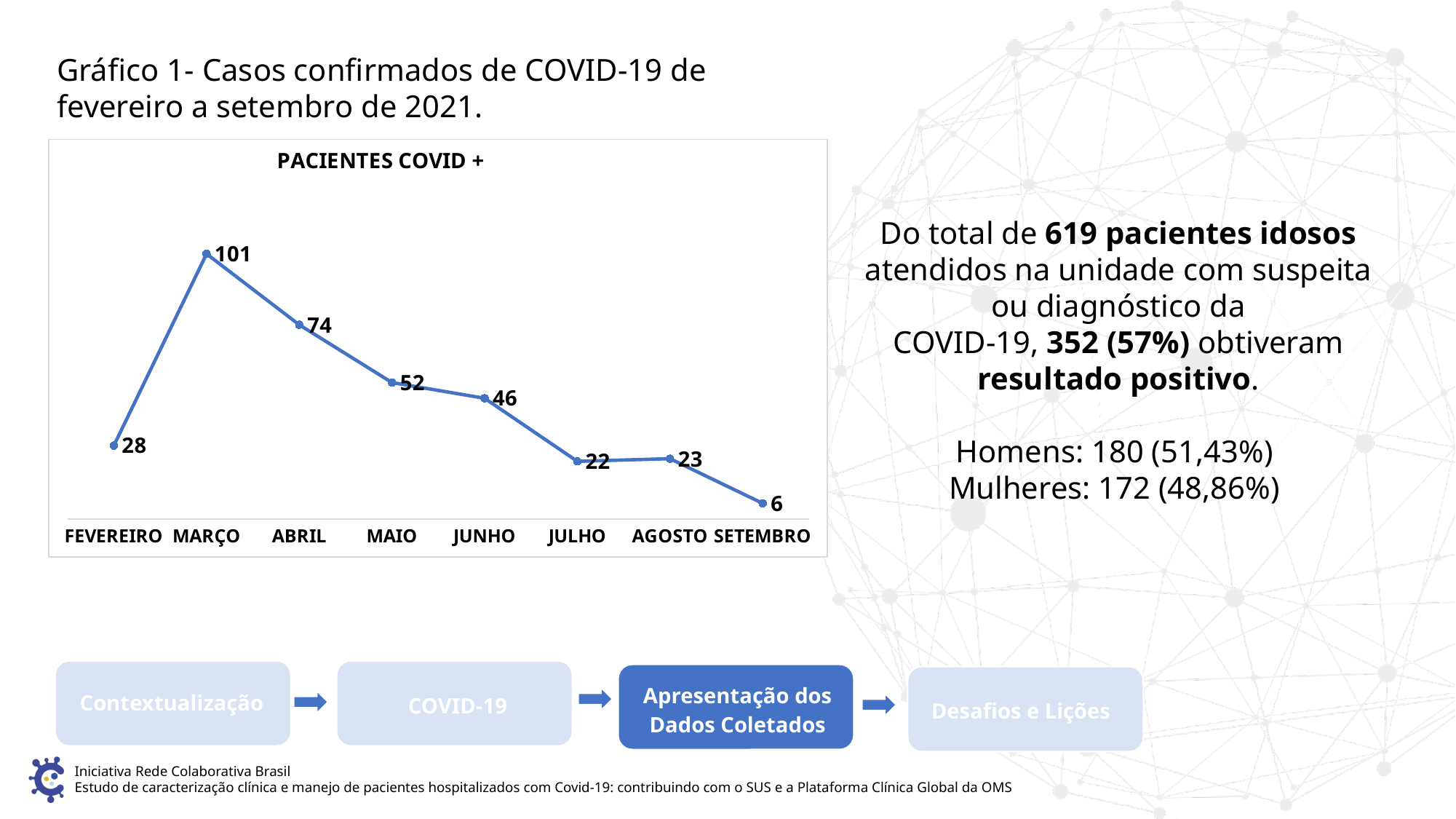
How many months are plotted in the PACIENTES COVID + chart? 8 What is the difference between the values for MAIO and JUNHO in the PACIENTES COVID + chart? 6 Which is larger in the PACIENTES COVID + chart, the value for FEVEREIRO or the value for JULHO? FEVEREIRO What is the value for JUNHO in the PACIENTES COVID + chart? 46 Which month has the lowest value in the PACIENTES COVID + chart? SETEMBRO What kind of chart is the PACIENTES COVID + chart? line chart Do the values in the PACIENTES COVID + chart rise or fall from MARÇO to SETEMBRO? fall What is the value for FEVEREIRO in the PACIENTES COVID + chart? 28 What is the value for SETEMBRO in the PACIENTES COVID + chart? 6 What is the value for MARÇO in the PACIENTES COVID + chart? 101 Which month has the highest value in the PACIENTES COVID + chart? MARÇO What is the difference between the values for MARÇO and ABRIL in the PACIENTES COVID + chart? 27